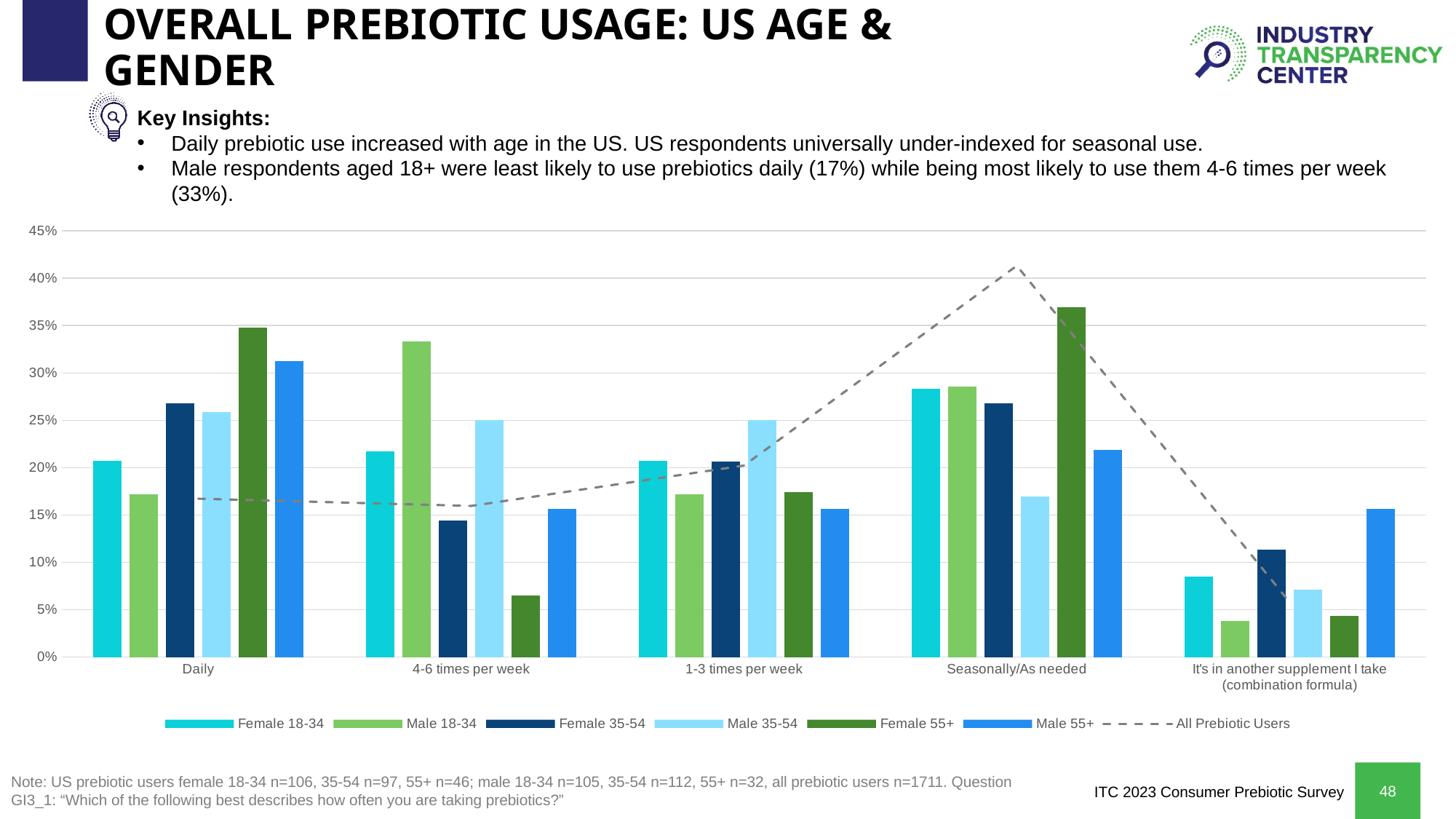
Which group has the lowest value in the 4-6 times per week category? Female 55+ Which group has the highest value in the 4-6 times per week category? Male 18-34 Which series is shown as a dashed line rather than bars? All Prebiotic Users Which group has the highest value in the Daily category? Female 55+ How many series does the legend list? 7 Which group has the highest value in the Seasonally/As needed category? Female 55+ Is the value for Male 35-54 in the Seasonally/As needed category greater or less than 20%? less What kind of chart is shown on the slide? combination bar and line chart Which group has the lowest value in the Daily category? Male 18-34 Is the value for Female 55+ in the Seasonally/As needed category greater or less than 35%? greater How many frequency categories are shown along the x axis? 5